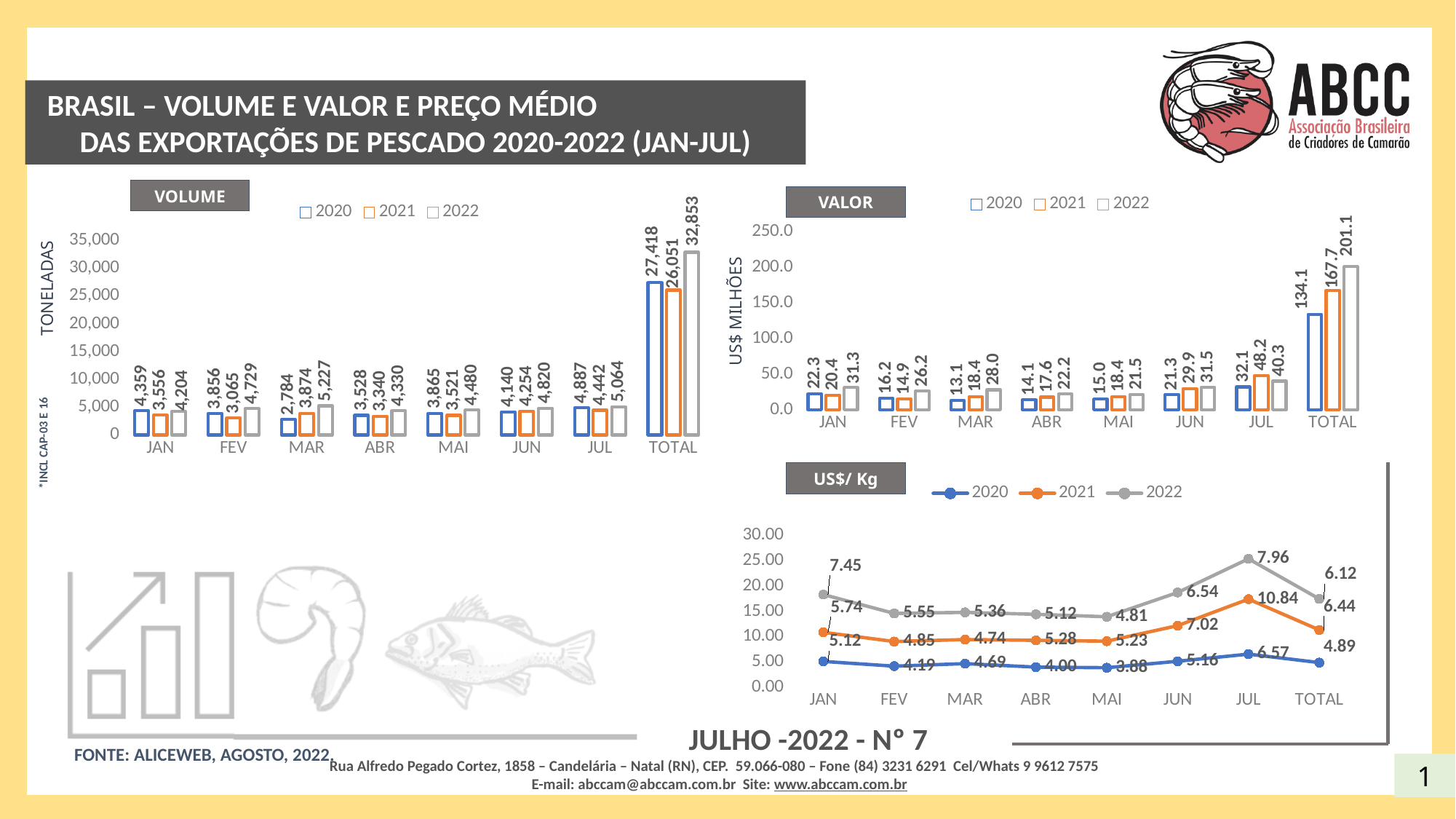
In the VOLUME chart, which series has the highest TOTAL value? 2022 In the VALOR chart, what is the difference between the 2022 and 2020 TOTAL values? 67.0 In the VALOR chart, what is the 2021 value for JUL? 48.2 In the VOLUME chart, what is the difference between the 2022 and 2021 values for JUL? 622 In the VOLUME chart, what is the 2020 value for MAR? 2,784 In the VOLUME chart, what is the 2022 value for TOTAL? 32,853 In the VALOR chart, is the 2021 value for JUL larger or smaller than the 2022 value for JUL? larger What type of chart is the US$/Kg chart? line chart In the US$/Kg chart, what is the 2020 value for MAI? 3.88 In the VALOR chart, which month has the lowest 2020 value? MAR In the US$/Kg chart, what is the 2021 value for JUL? 10.84 How many series does the legend of the VOLUME chart list? 3